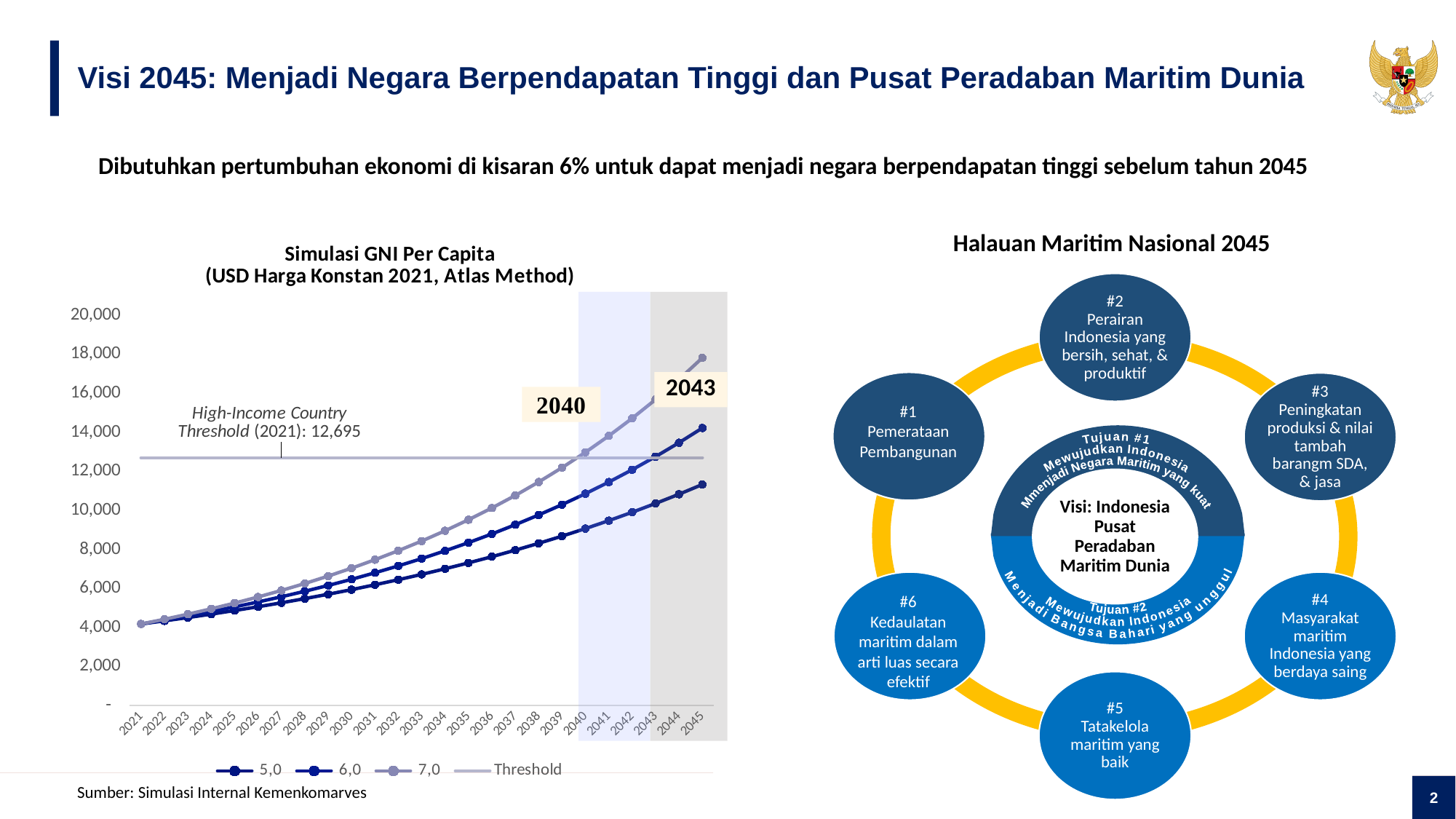
Which series has the lowest value in 2045 on the 'Simulasi GNI Per Capita' chart? 5,0 Is the value of the 7,0 series in 2045 greater or less than 16,000 on the 'Simulasi GNI Per Capita' chart? greater How many years are shown on the x axis of the 'Simulasi GNI Per Capita' chart? 25 Is the value of the 5,0 series in 2045 greater or less than 12,000 on the 'Simulasi GNI Per Capita' chart? less Which series has the highest value in 2045 on the 'Simulasi GNI Per Capita' chart? 7,0 What are the legend entries of the 'Simulasi GNI Per Capita' chart? 5,0, 6,0, 7,0, Threshold Do the values of the 7,0 series rise or fall from 2021 to 2045 on the 'Simulasi GNI Per Capita' chart? rise How many series does the legend of the 'Simulasi GNI Per Capita' chart list? 4 In 2045, which series is larger on the 'Simulasi GNI Per Capita' chart: 7,0 or 5,0? 7,0 What is the High-Income Country Threshold (2021) value shown on the 'Simulasi GNI Per Capita' chart? 12,695 What is the first year shown on the x axis of the 'Simulasi GNI Per Capita' chart? 2021 What kind of chart is the 'Simulasi GNI Per Capita' chart? line chart